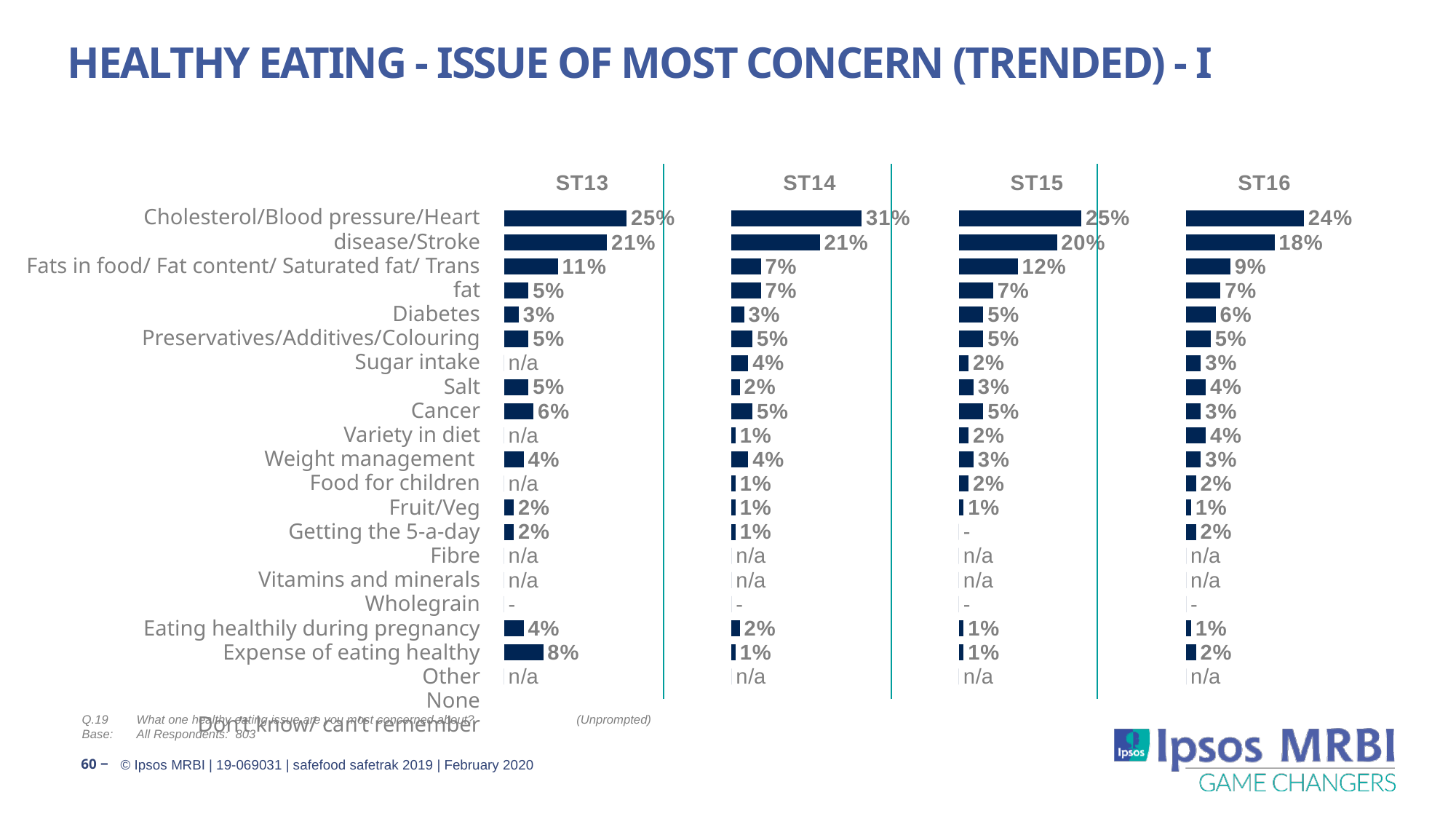
Does the value of the second bar from the top rise or fall from ST14 (21%) to ST16 (18%)? Fall In the ST16 chart, what is the value of the second bar from the top? 18% Which survey wave has the highest value for its top bar? ST14 In the ST13 chart, what is the value of the top bar? 25% Is the top bar value larger in ST13 or in ST16? ST13 In the ST16 chart, what is the value of the top bar? 24% What is the difference between the top bar value in ST14 (31%) and the top bar value in ST13 (25%)? 6% What is the difference between the top bar value in ST15 (25%) and the top bar value in ST16 (24%)? 1% What is the title of the slide? HEALTHY EATING - ISSUE OF MOST CONCERN (TRENDED) - I In the ST14 chart, what is the highest value shown? 31% How many survey waves (ST columns) are shown on the slide? 4 What kind of chart is used on this slide to show the ST13 to ST16 results? Bar chart